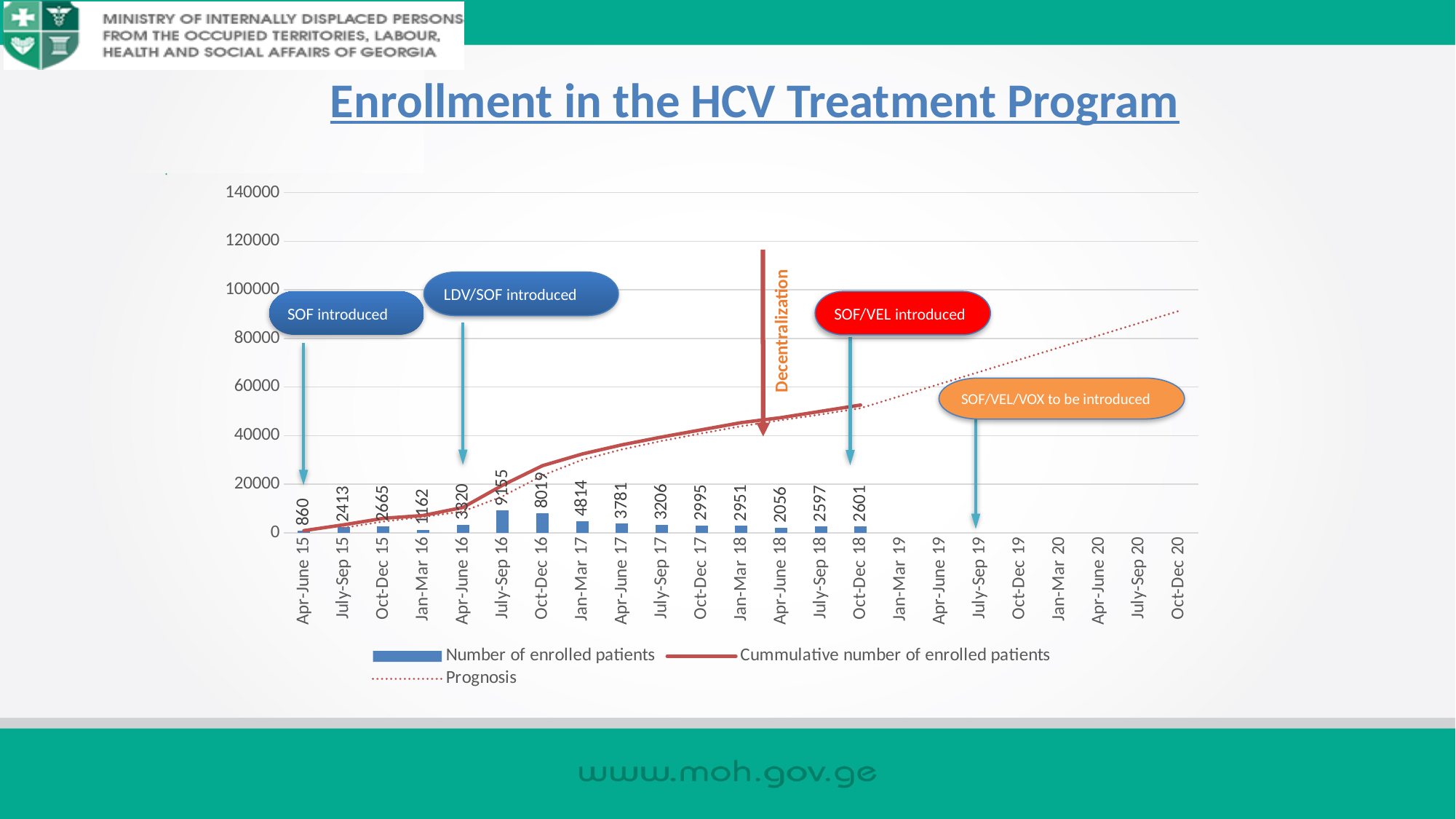
Which quarter has more enrolled patients, Jan-Mar 17 or Apr-June 17? Jan-Mar 17 What is the number of enrolled patients for Oct-Dec 18? 2601 Is the Prognosis value at Oct-Dec 20 greater or less than 80000? greater Does the cumulative number of enrolled patients rise or fall over time? rise Is the cumulative number of enrolled patients at Oct-Dec 18 greater or less than 40000? greater What is the title of the chart? Enrollment in the HCV Treatment Program What is the number of enrolled patients for July-Sep 16? 9155 What is the difference in the number of enrolled patients between July-Sep 16 and Oct-Dec 16? 1136 How many series does the legend list? 3 Which quarter has the highest number of enrolled patients? July-Sep 16 Which quarter has the lowest number of enrolled patients? Apr-June 15 What is the number of enrolled patients for Apr-June 15? 860